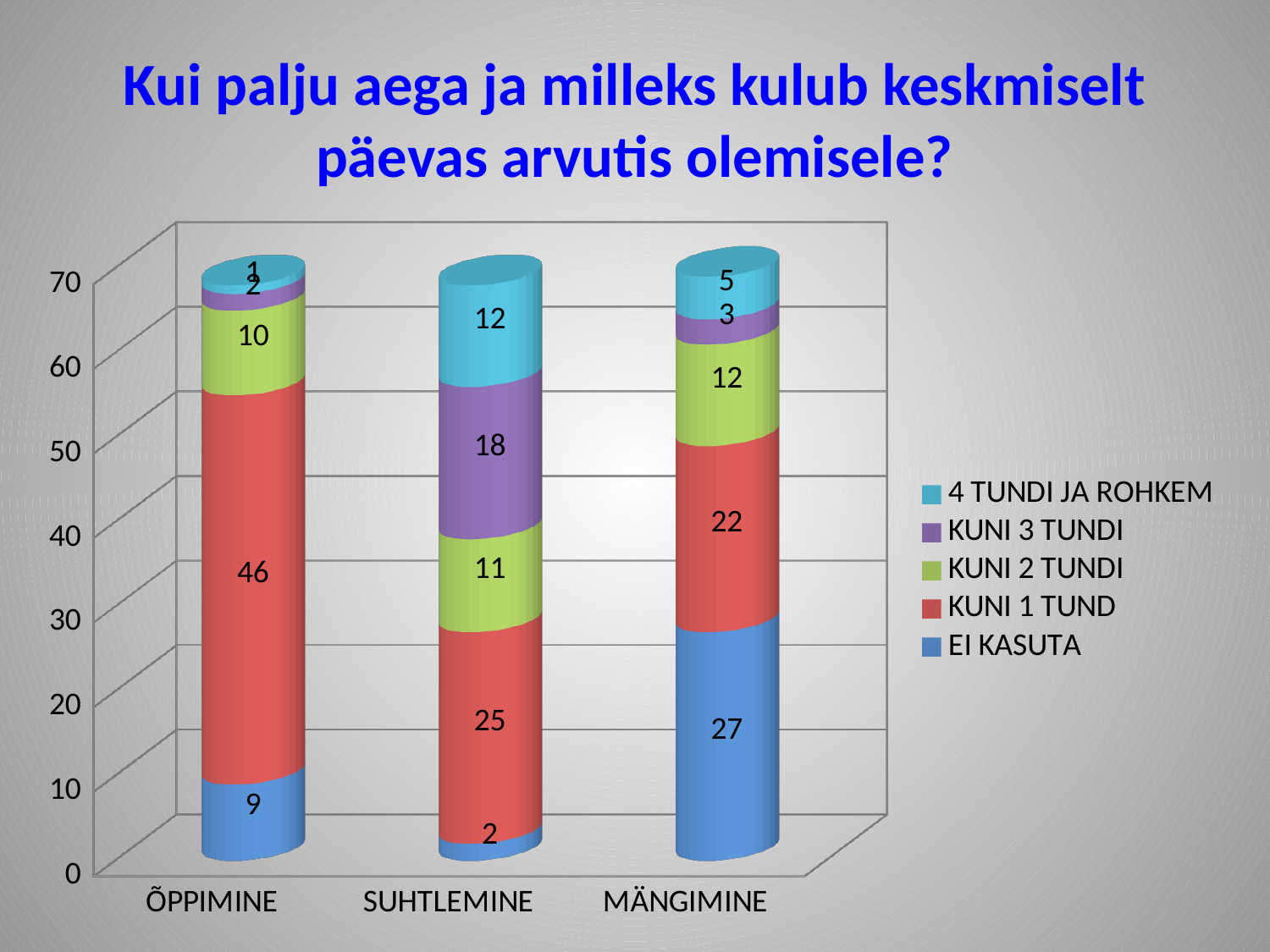
Which category has the highest KUNI 3 TUNDI value? SUHTLEMINE What kind of chart is shown on the slide? stacked bar chart What is the value for KUNI 3 TUNDI in the SUHTLEMINE bar? 18 How many series does the legend list? 5 What is the value for EI KASUTA in the MÄNGIMINE bar? 27 What is the value for 4 TUNDI JA ROHKEM in the ÕPPIMINE bar? 1 Which is larger: the EI KASUTA value for SUHTLEMINE or for MÄNGIMINE? MÄNGIMINE What is the total of the SUHTLEMINE stacked bar? 68 What is the difference between the KUNI 1 TUND values for ÕPPIMINE and MÄNGIMINE? 24 Which legend entry is shown in red? KUNI 1 TUND How many categories are shown on the x axis? 3 What is the value for KUNI 1 TUND in the ÕPPIMINE bar? 46